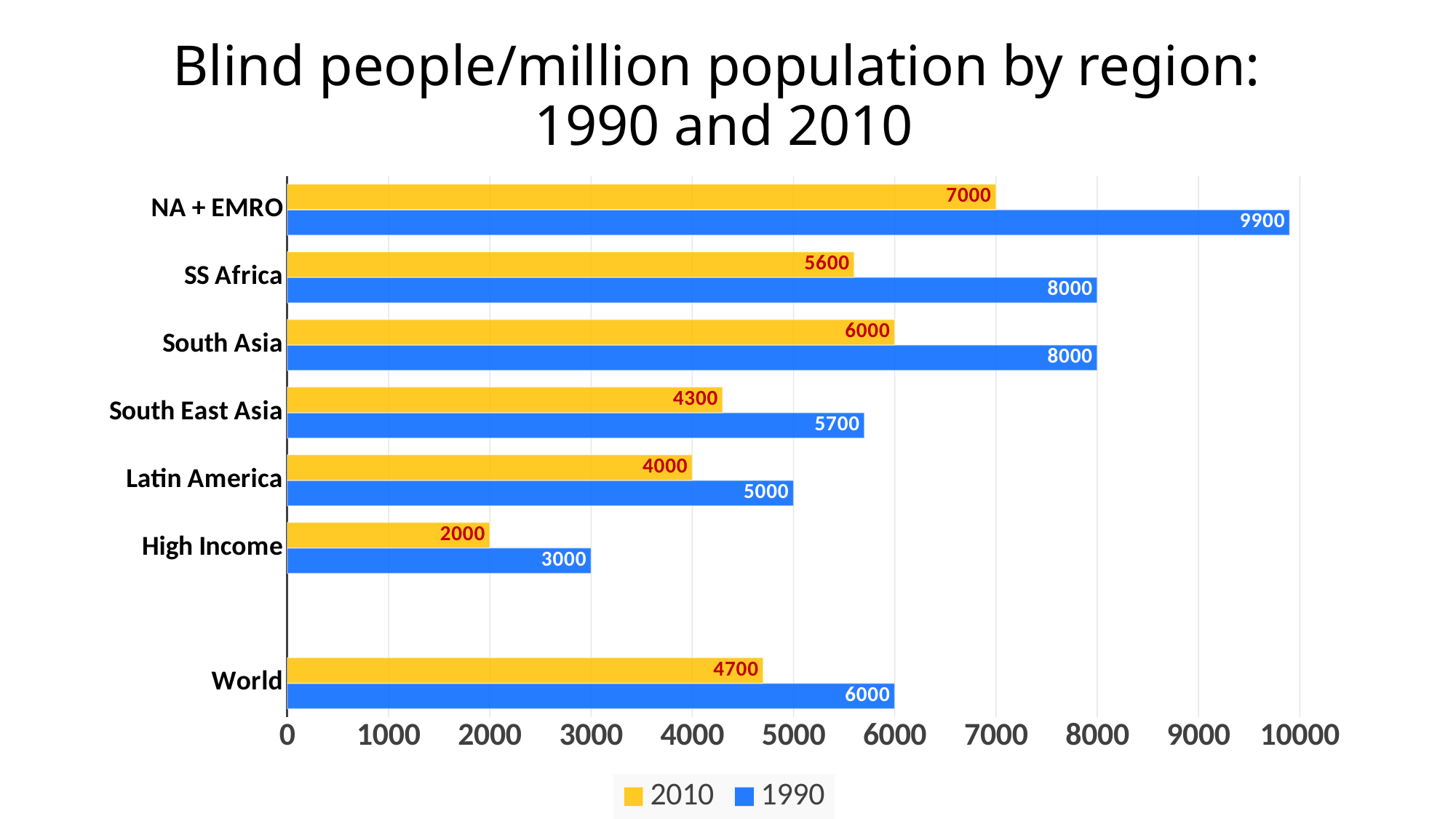
How many regions (categories) are shown on the chart? 7 How many series does the legend list? 2 What is the difference between the 1990 and 2010 values for SS Africa? 2400 What is the 1990 value for NA + EMRO? 9900 What is the difference between the 1990 and 2010 values for High Income? 1000 What is the 2010 value for South East Asia? 4300 What is the 2010 value for World? 4700 Which is larger: the 2010 value for South Asia or the 2010 value for SS Africa? South Asia Which colour represents the 1990 series? Blue Which region has the highest 2010 value? NA + EMRO Which region has the lowest 1990 value? High Income What kind of chart is shown on the slide? Bar chart